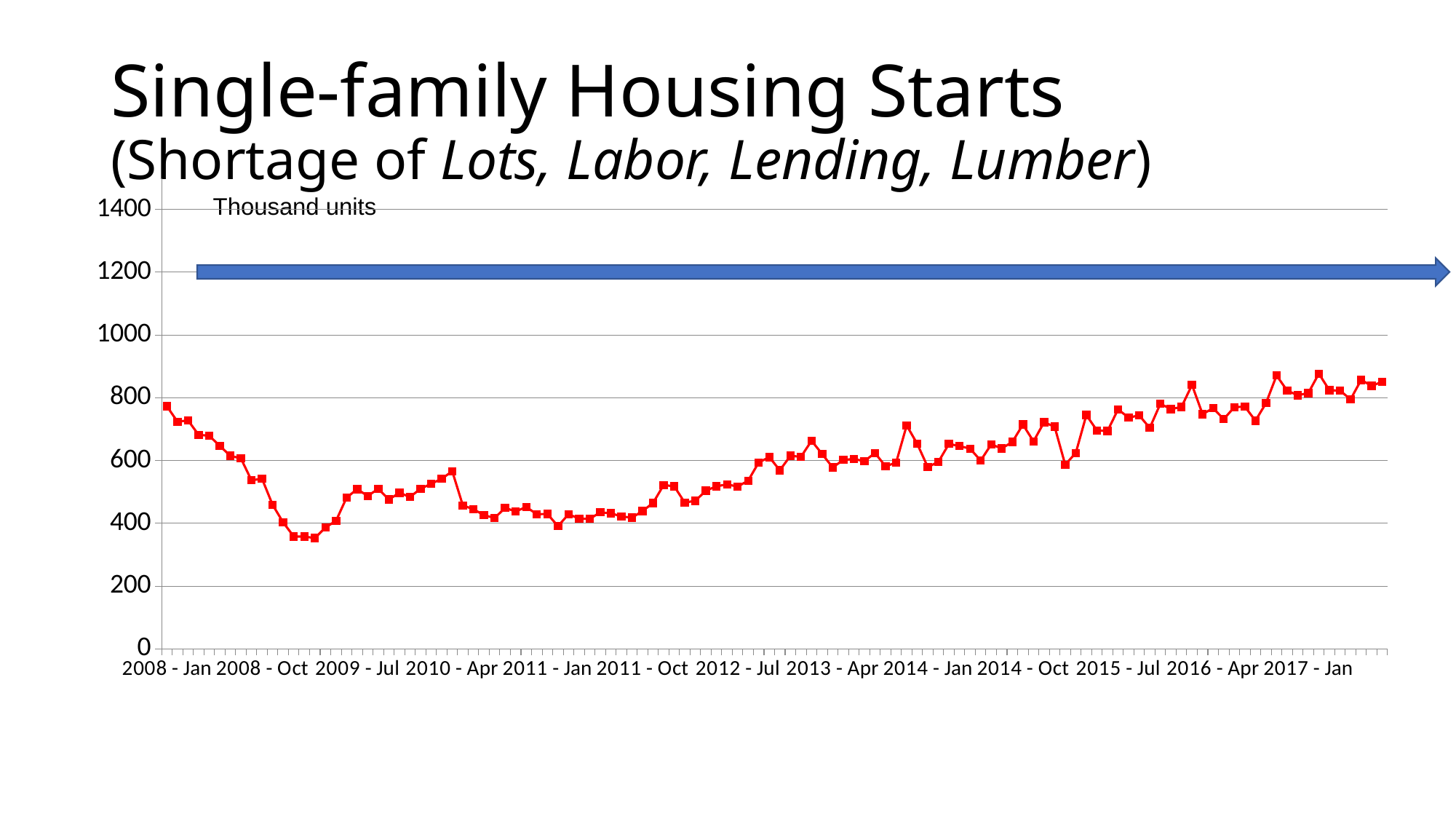
What kind of chart is shown on the slide? line chart Do the values rise or fall along the x axis between 2011 - Oct and 2017 - Jan? rise What is the title of the chart on the slide? Single-family Housing Starts Do the values rise or fall along the x axis between 2008 - Jan and 2008 - Oct? fall Is the value for 2015 - Jul greater or less than 600? greater Is the value for 2011 - Jan greater or less than 600? less Is the value for 2008 - Jan greater or less than 600? greater Which is larger, the value for 2008 - Jan or the value for 2017 - Jan? 2017 - Jan What unit label is shown at the top of the chart's y axis? Thousand units Which is larger, the value for 2008 - Oct or the value for 2013 - Apr? 2013 - Apr